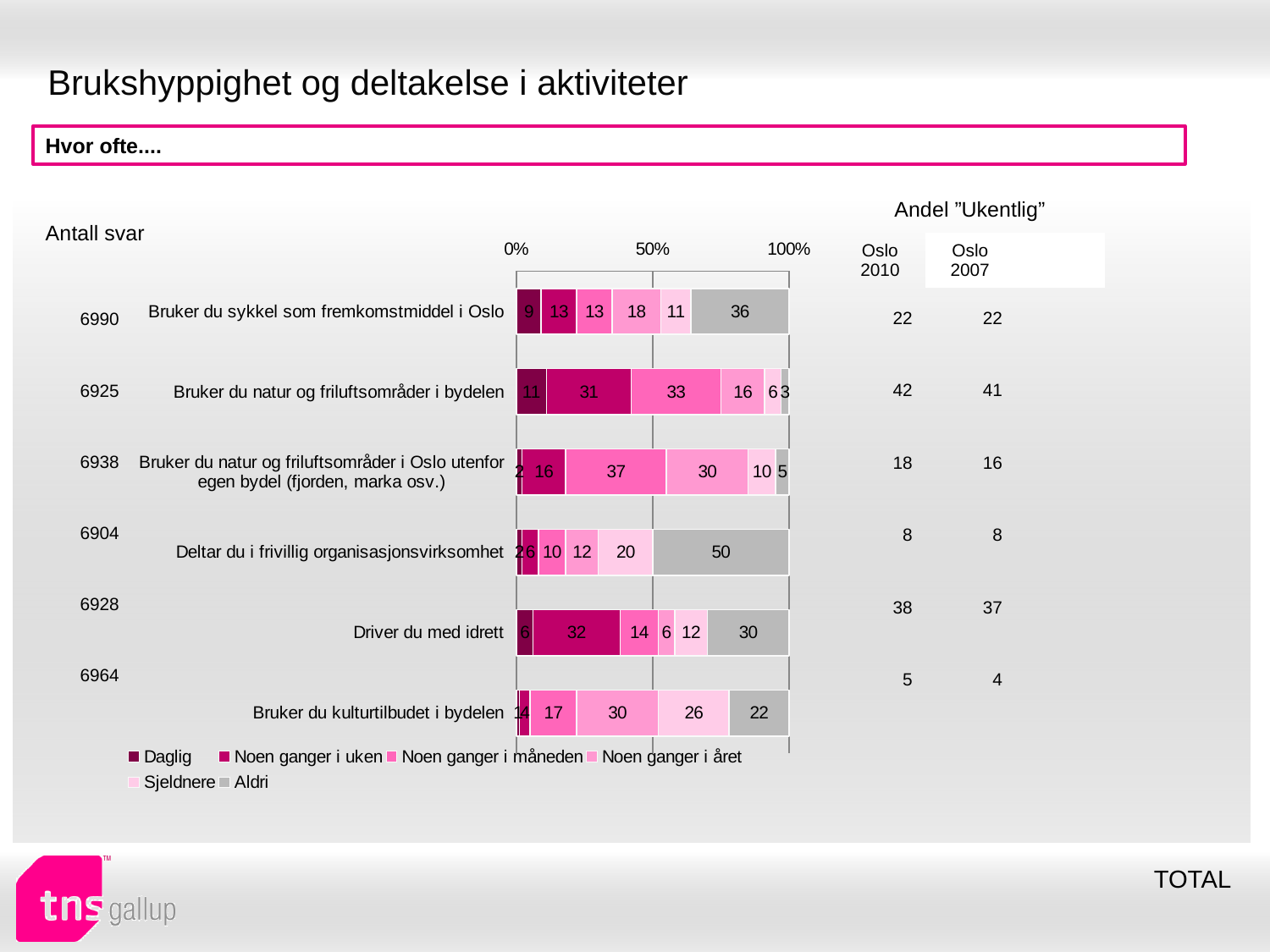
How many categories (questions) are shown in the chart? 6 What kind of chart is shown on the slide? Stacked bar chart Which category has the lowest "Aldri" value? Bruker du natur og friluftsområder i bydelen What is the value for "Noen ganger i året" for "Bruker du kulturtilbudet i bydelen"? 30 What is the value for "Aldri" for "Bruker du sykkel som fremkomstmiddel i Oslo"? 36 Which category has the highest "Aldri" value? Deltar du i frivillig organisasjonsvirksomhet How many series does the legend list? 6 What is the value for "Noen ganger i uken" for "Driver du med idrett"? 32 What is the value for "Aldri" for "Deltar du i frivillig organisasjonsvirksomhet"? 50 What is the difference between the "Aldri" values for "Bruker du sykkel som fremkomstmiddel i Oslo" and "Driver du med idrett"? 6 What is the value for "Noen ganger i måneden" for "Bruker du natur og friluftsområder i Oslo utenfor egen bydel (fjorden, marka osv.)"? 37 Which is larger: the "Aldri" value for "Deltar du i frivillig organisasjonsvirksomhet" or for "Bruker du kulturtilbudet i bydelen"? Deltar du i frivillig organisasjonsvirksomhet